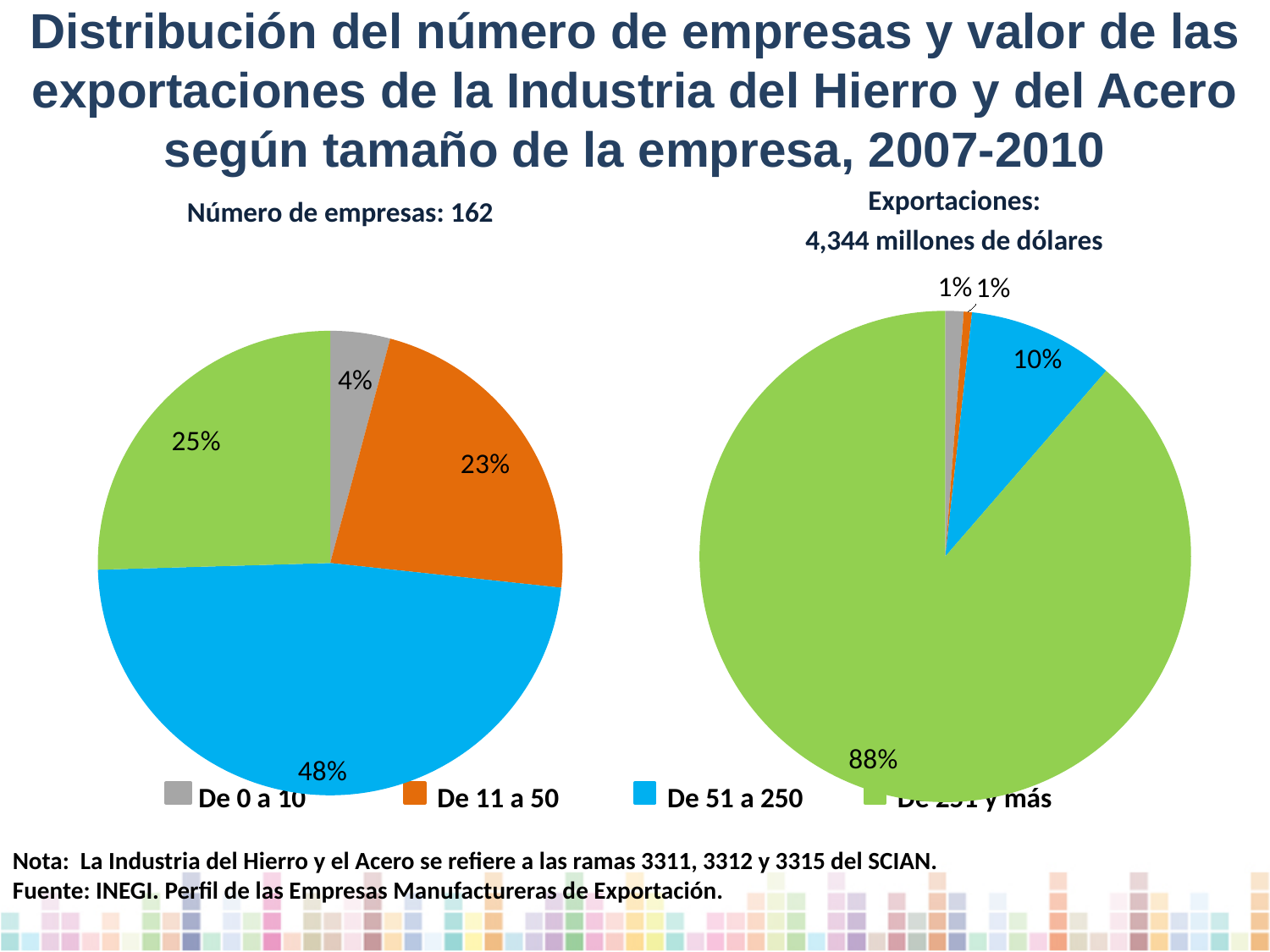
In the 'Número de empresas: 162' chart, which company size has the smallest share? De 0 a 10 In the 'Número de empresas: 162' chart, which company size has the largest share? De 51 a 250 In the 'Número de empresas: 162' chart, what is the difference between the shares of 'De 51 a 250' and 'De 251 y más'? 23 percentage points Which colour represents 'De 11 a 50' in the charts? Orange In the 'Exportaciones: 4,344 millones de dólares' chart, what share do companies 'De 251 y más' represent? 88% In the 'Exportaciones: 4,344 millones de dólares' chart, what share do companies 'De 51 a 250' represent? 10% How many categories does the legend list? 4 In the 'Número de empresas: 162' chart, what share do companies 'De 51 a 250' represent? 48% What kind of chart is used for 'Número de empresas: 162'? Pie chart In the 'Exportaciones: 4,344 millones de dólares' chart, which company size has the largest share? De 251 y más